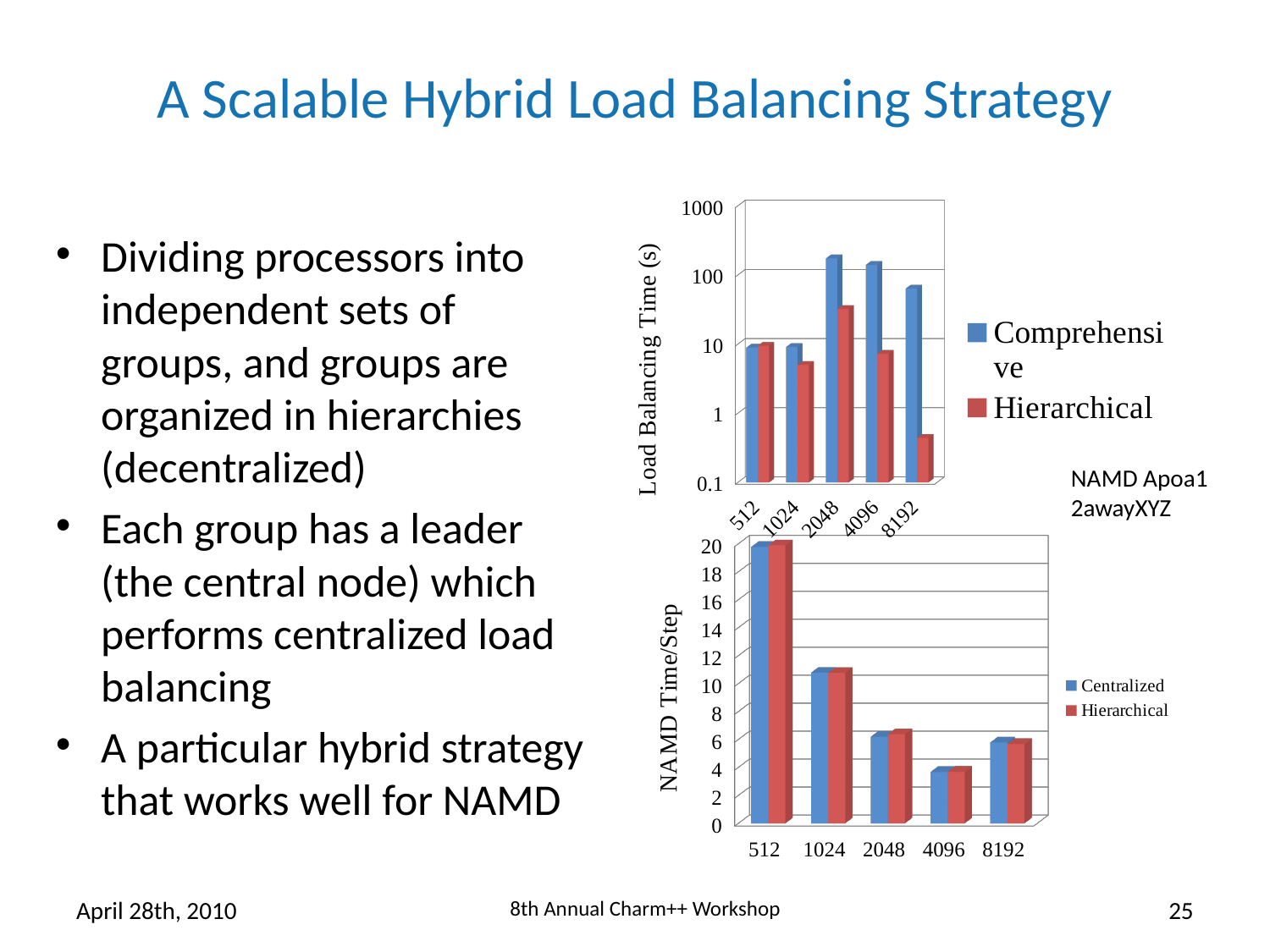
In the bottom chart (NAMD Time/Step), which category has the lowest Hierarchical value? 4096 How many categories are shown on the x axis of the bottom chart (NAMD Time/Step)? 5 How many series does the legend of the top chart (Load Balancing Time) list? 2 In the top chart (Load Balancing Time), is the Comprehensive value for 2048 greater or less than 100? greater In the bottom chart (NAMD Time/Step), which category has the highest Centralized value? 512 In the top chart (Load Balancing Time), for which category is the Hierarchical value lowest? 8192 In the bottom chart (NAMD Time/Step), is the Centralized value for 1024 greater or less than 10? greater What are the two series named in the legend of the bottom chart (NAMD Time/Step)? Centralized and Hierarchical What kind of chart is the top chart on the slide (Load Balancing Time)? bar chart In the top chart (Load Balancing Time), is the Hierarchical value for 1024 greater or less than 10? less In the top chart (Load Balancing Time), which is larger at 8192: Comprehensive or Hierarchical? Comprehensive